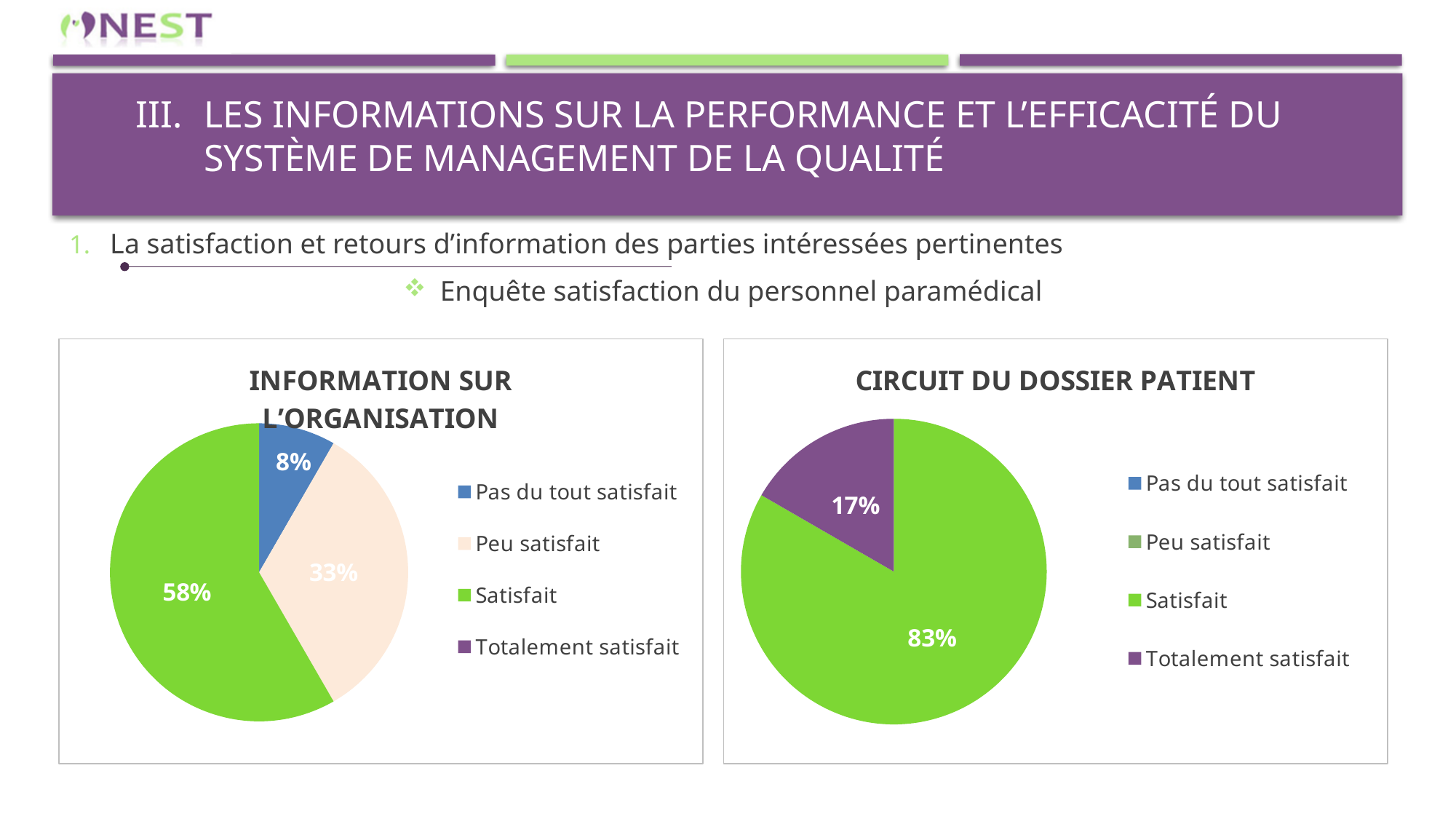
In the 'CIRCUIT DU DOSSIER PATIENT' chart, what percentage is shown for Satisfait? 83% What type of chart is the 'CIRCUIT DU DOSSIER PATIENT' chart? Pie chart In the 'INFORMATION SUR L'ORGANISATION' chart, what is the difference between the Satisfait and Peu satisfait percentages? 25% In the 'CIRCUIT DU DOSSIER PATIENT' chart, which category has the largest share? Satisfait In the 'INFORMATION SUR L'ORGANISATION' chart, what percentage is shown for Peu satisfait? 33% How many entries does the legend of the 'INFORMATION SUR L'ORGANISATION' chart list? 4 In the 'CIRCUIT DU DOSSIER PATIENT' chart, what is the difference between the Satisfait and Totalement satisfait percentages? 66% In the 'INFORMATION SUR L'ORGANISATION' chart, which is larger: Peu satisfait or Pas du tout satisfait? Peu satisfait In the 'INFORMATION SUR L'ORGANISATION' chart, which category has the largest share? Satisfait In the 'CIRCUIT DU DOSSIER PATIENT' chart, what percentage is shown for Totalement satisfait? 17% In the 'INFORMATION SUR L'ORGANISATION' chart, what percentage is shown for Pas du tout satisfait? 8% In the 'INFORMATION SUR L'ORGANISATION' chart, what percentage is shown for Satisfait? 58%